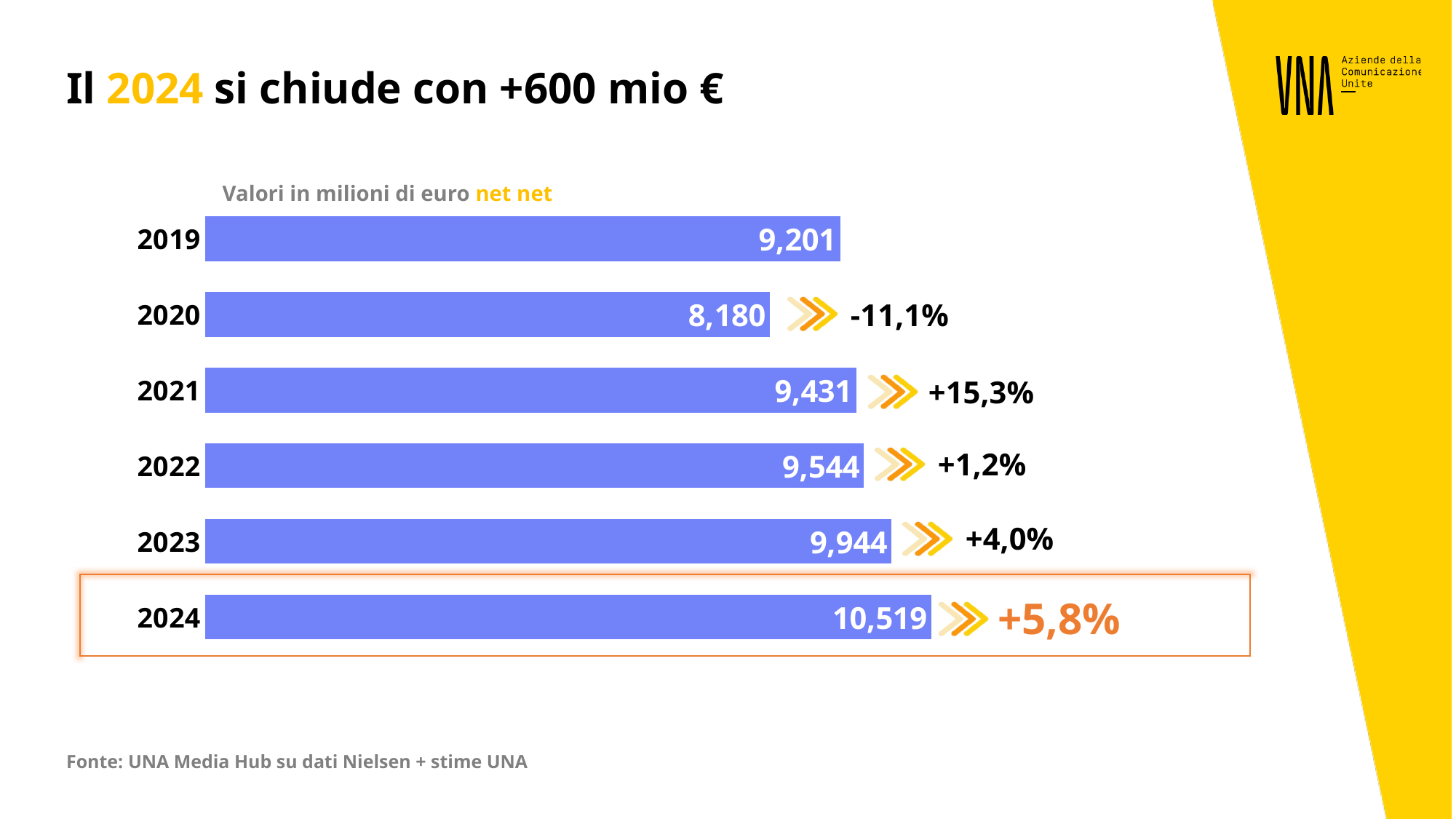
Which year has the lowest value? 2020 What is the value for 2019? 9,201 Which is larger, the value for 2021 or the value for 2022? 2022 Which year has the highest value? 2024 What kind of chart is shown on the slide? bar chart What is the difference between the values for 2024 and 2023? 575 What is the value for 2020? 8,180 What is the value for 2024? 10,519 What percentage change is shown next to the 2021 bar? +15,3% What is the difference between the values for 2019 and 2020? 1,021 Do the values rise or fall from 2020 to 2024? rise How many years are shown in the chart? 6